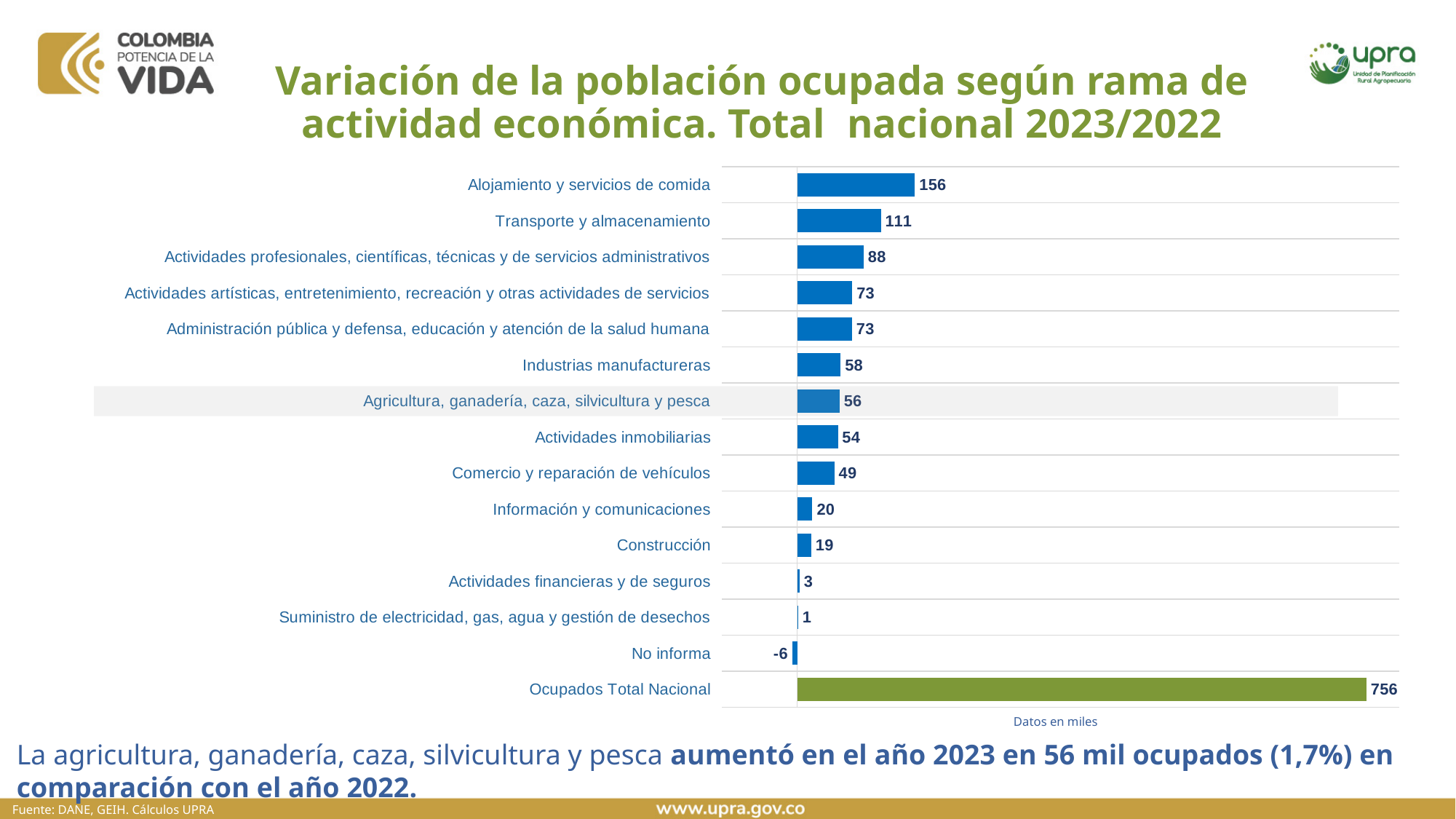
What is the difference between Construcción and Actividades financieras y de seguros? 16 What kind of chart is shown on the slide? Bar chart Which is larger, Industrias manufactureras or Comercio y reparación de vehículos? Industrias manufactureras What unit note is printed below the chart? Datos en miles What is the value for Agricultura, ganadería, caza, silvicultura y pesca? 56 What is the difference between Alojamiento y servicios de comida and Transporte y almacenamiento? 45 What is the value for Ocupados Total Nacional? 756 Which category has the lowest value? No informa What is the value for No informa? -6 What is the value for Alojamiento y servicios de comida? 156 Excluding Ocupados Total Nacional, which category has the highest value? Alojamiento y servicios de comida How many categories are shown in the chart? 15